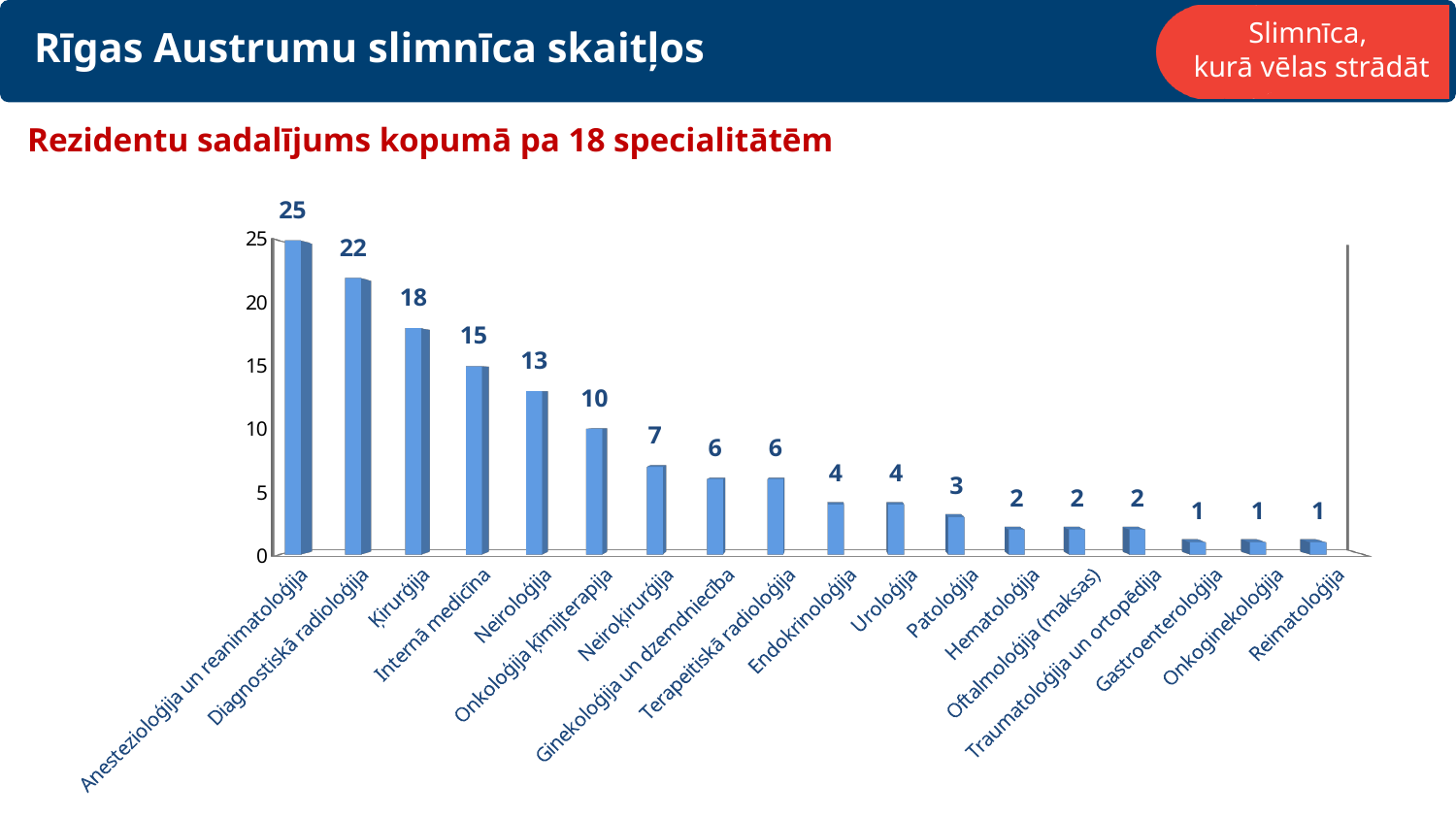
What is the title of the chart? Rezidentu sadalījums kopumā pa 18 specialitātēm How many specialties (categories) are shown in the chart? 18 How many residents are in Anestezioloģija un reanimatoloģija? 25 What is the difference between Ķirurģija and Uroloģija? 14 What is the value for Patoloģija? 3 What is the value for Onkoloģija ķīmijterapija? 10 Which is larger, Neiroloģija or Neiroķirurģija? Neiroloģija What kind of chart is shown on the slide? Bar chart What is the difference between Diagnostiskā radioloģija and Internā medicīna? 7 Do the values rise or fall from left to right along the x axis? Fall Which specialty has the highest number of residents? Anestezioloģija un reanimatoloģija What is the value for Ķirurģija? 18